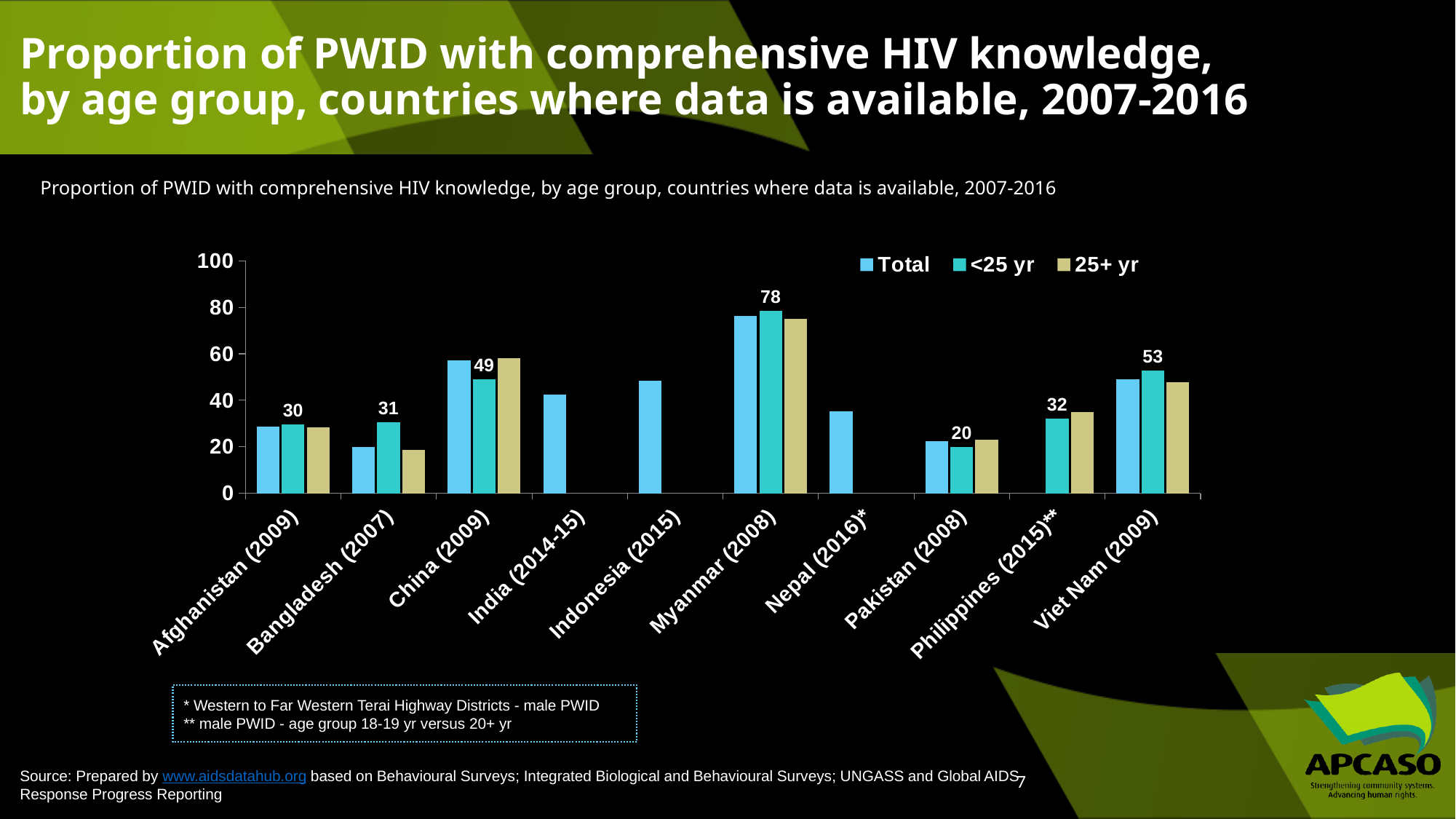
How many series does the legend list? 3 What is the value for the <25 yr series for Pakistan (2008)? 20 How many countries are shown on the x axis of the chart? 10 What is the difference between the <25 yr values for Myanmar (2008) and Viet Nam (2009)? 25 What is the value for the <25 yr series for Myanmar (2008)? 78 Which country has the highest value in the <25 yr series? Myanmar (2008) Which country has the lowest labelled value in the <25 yr series? Pakistan (2008) Is the Total value for Myanmar (2008) greater or less than 60? greater Which is larger, the <25 yr value for Viet Nam (2009) or for China (2009)? Viet Nam (2009) Is the Total value for Indonesia (2015) greater or less than 60? less What is the value for the <25 yr series for China (2009)? 49 What kind of chart is shown on the slide? Bar chart